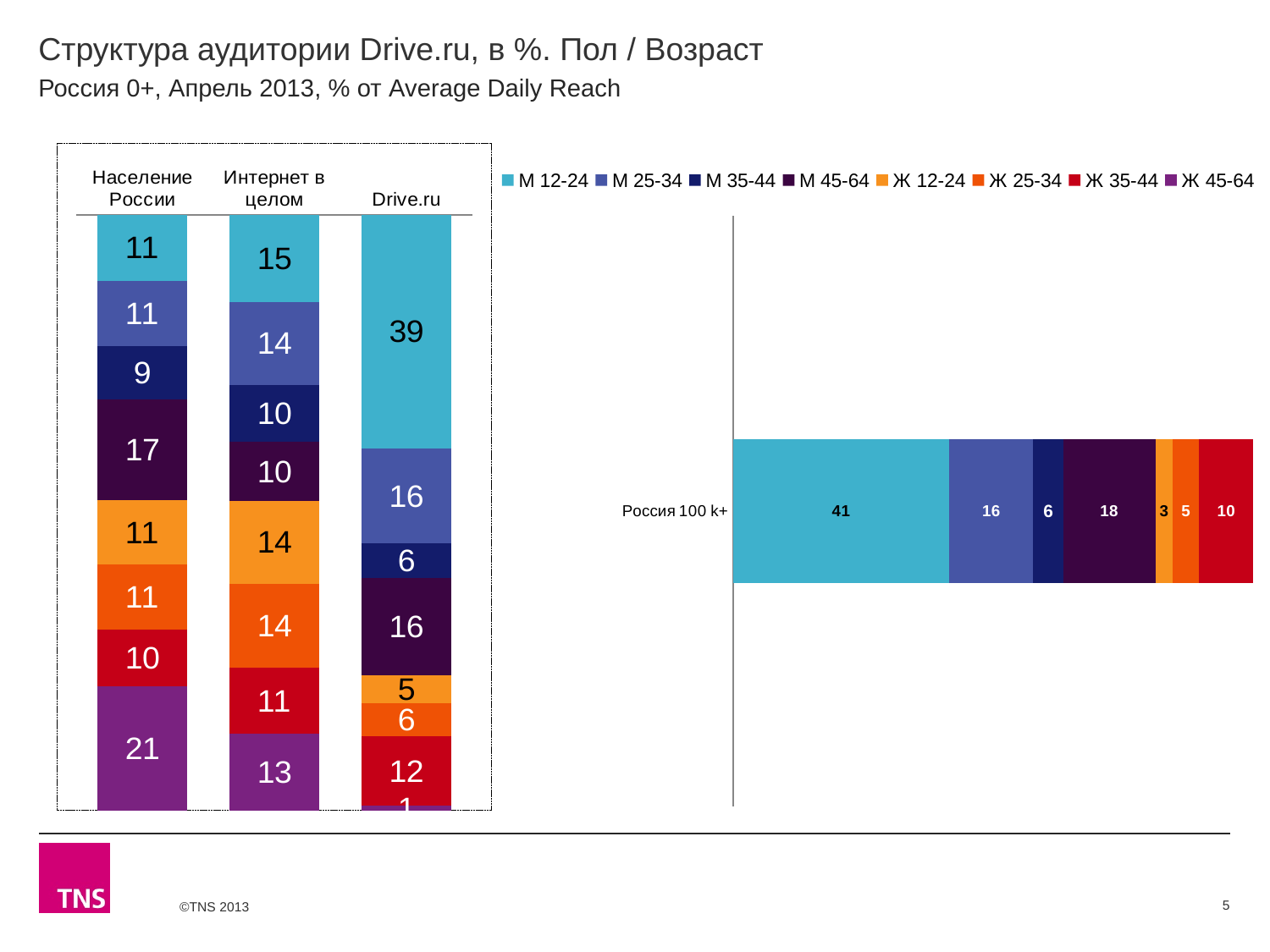
In the right chart, what is the label of the single bar? Россия 100 k+ In the left chart, which segment is the smallest in the Drive.ru bar? Ж 45-64 In the left chart, which is larger for Drive.ru: the Ж 35-44 segment or the Ж 12-24 segment? Ж 35-44 In the right chart, what is the difference between the М 45-64 and М 25-34 values for Россия 100 k+? 2 In the left chart, what is the М 12-24 value for Drive.ru? 39 In the right chart, what is the value of the М 12-24 segment for Россия 100 k+? 41 How many series does the legend list? 8 In the left chart, what is the Ж 45-64 value for Население России? 21 How many bars are shown in the left chart? 3 In the left chart, what is the М 35-44 value for Интернет в целом? 10 In the left chart, which segment is the largest in the Drive.ru bar? М 12-24 What kind of chart is the right chart? Stacked bar chart